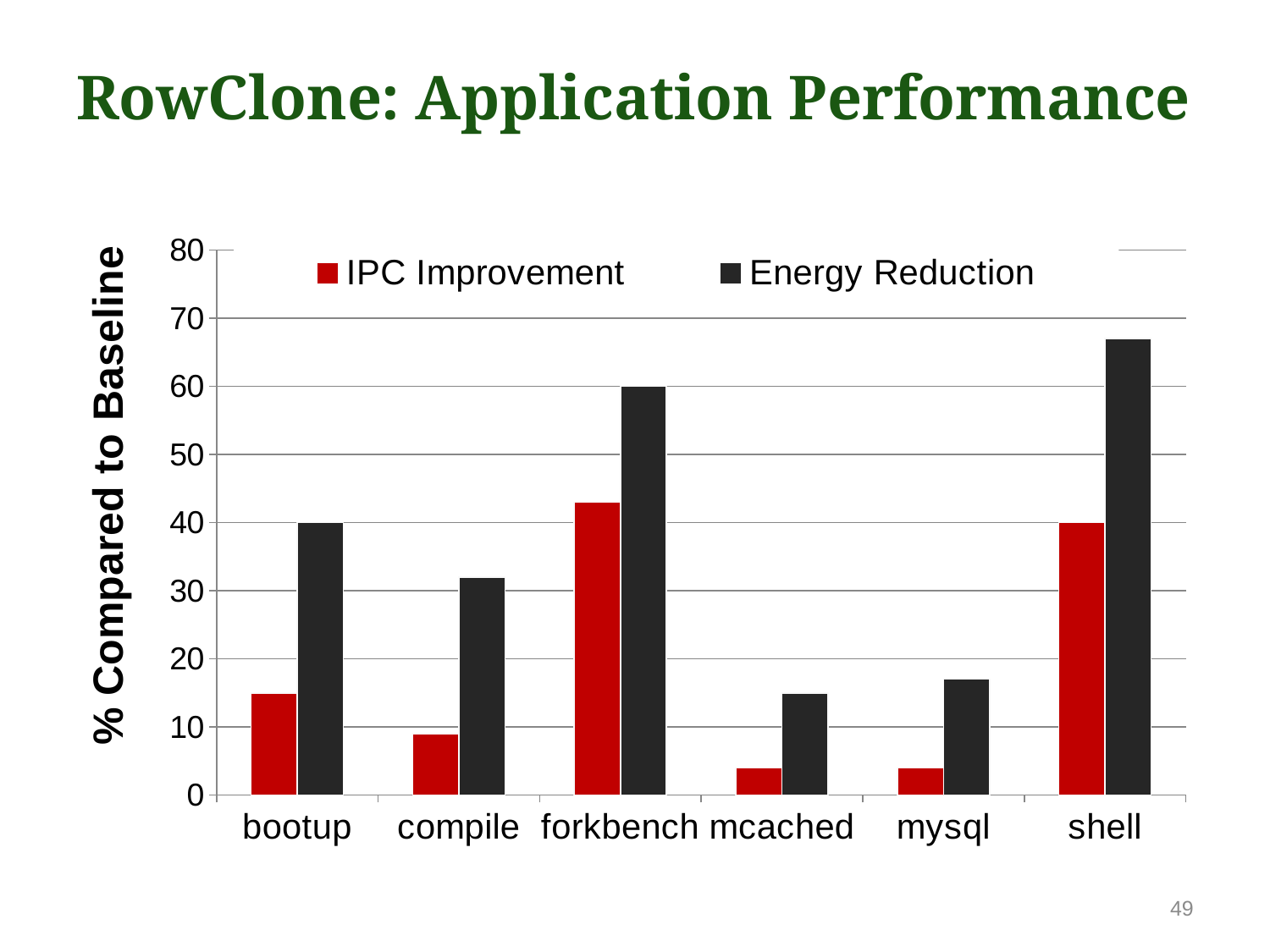
How many series does the legend list? 2 Which is larger: the Energy Reduction for forkbench or for shell? shell What is the label on the y axis? % Compared to Baseline Is the Energy Reduction for mysql greater or less than 20? less What type of chart is shown on the slide? bar chart Which application has the highest Energy Reduction? shell Is the Energy Reduction for shell greater or less than 60? greater Is the IPC Improvement for compile greater or less than 10? less Which application has the highest IPC Improvement? forkbench How many application categories are shown on the x axis? 6 What is the Energy Reduction value for forkbench? 60 What is the Energy Reduction value for bootup? 40